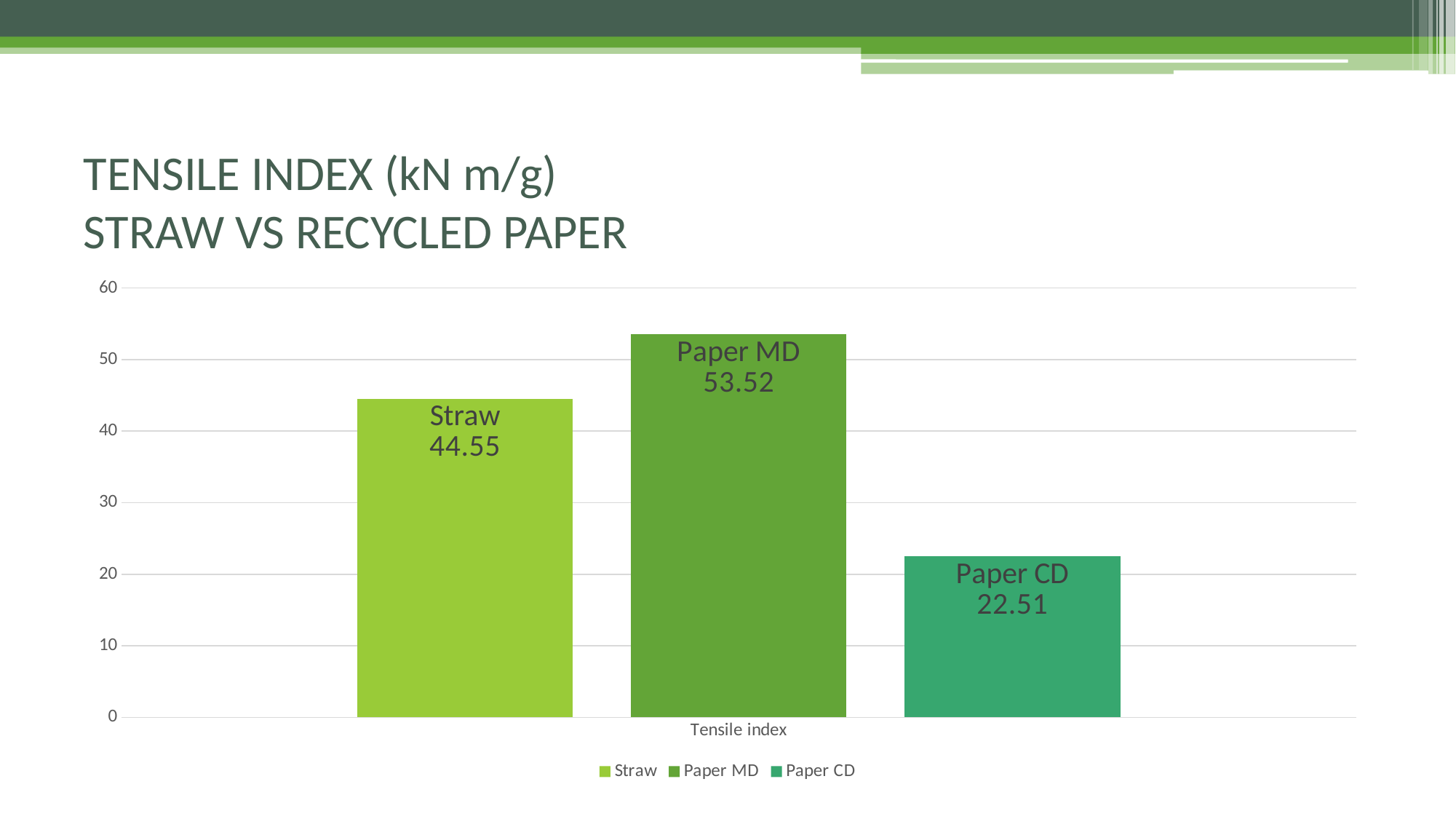
What is the label on the x axis of the chart? Tensile index Is the value for Paper MD greater or less than 50? greater What is the tensile index value for Straw? 44.55 How many series does the legend list? 3 Which has a larger tensile index, Straw or Paper CD? Straw What is the difference between the tensile index of Paper MD and Straw? 8.97 Which series has the lowest tensile index? Paper CD What is the tensile index value for Paper MD? 53.52 Which series has the highest tensile index? Paper MD What is the tensile index value for Paper CD? 22.51 What is the difference between the tensile index of Straw and Paper CD? 22.04 What kind of chart is shown on the slide? bar chart